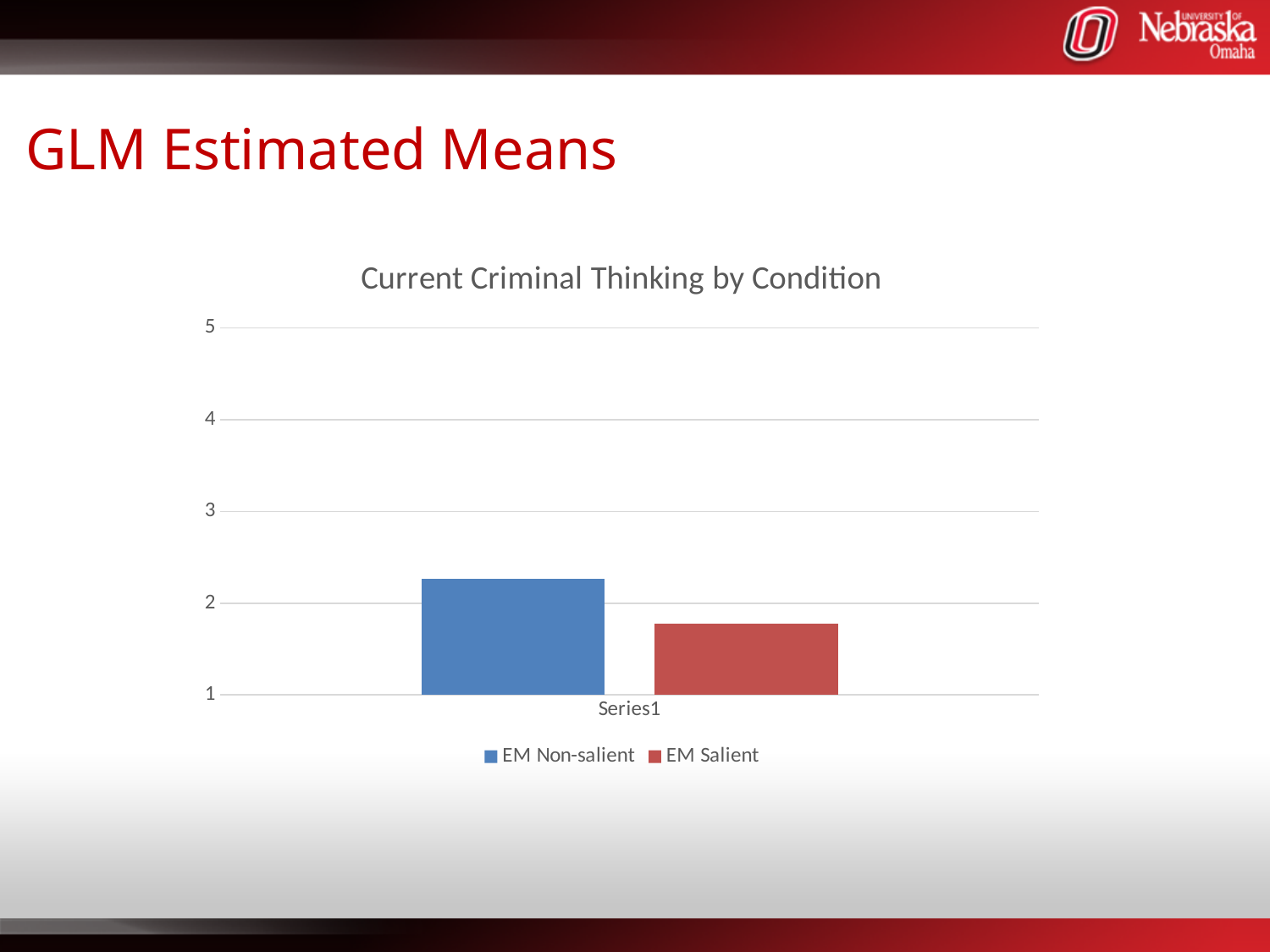
Which series has the higher value, EM Non-salient or EM Salient? EM Non-salient Which series has the highest bar? EM Non-salient Is the value for EM Salient greater or less than 2? less What kind of chart is shown on the slide? bar chart Is the value for EM Non-salient greater or less than 2? greater Which series has the lowest bar? EM Salient What is the title of the chart? Current Criminal Thinking by Condition Is the value for EM Non-salient greater or less than 3? less What colour is the bar for EM Salient? red How many series does the legend list? 2 How many categories are shown on the x axis? 1 What is the highest value shown on the vertical axis? 5